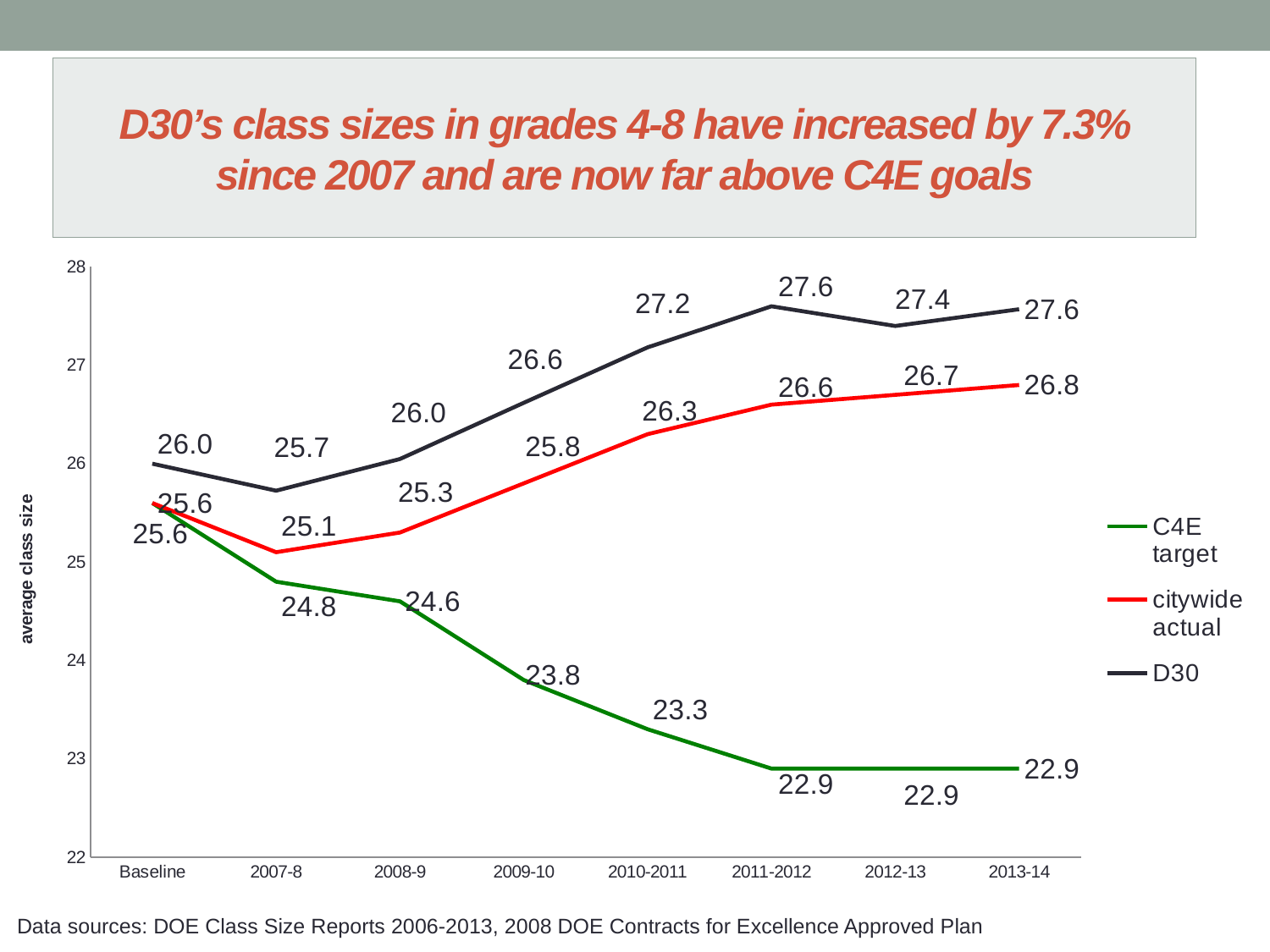
How many series does the legend list? 3 In which year does the D30 series reach its lowest value? 2007-8 What kind of chart is shown on the slide? Line chart How many points are plotted along the x axis for each series? 8 What is the highest value shown for the citywide actual series? 26.8 What is the difference between the D30 value and the C4E target value in 2013-14? 4.7 What is the citywide actual value for 2009-10? 25.8 What is the D30 value for 2013-14? 27.6 Which is larger in 2010-2011: the D30 value or the citywide actual value? D30 What is the C4E target value for 2008-9? 24.6 Does the C4E target series rise or fall from Baseline to 2013-14? Fall What is the label of the y axis? average class size